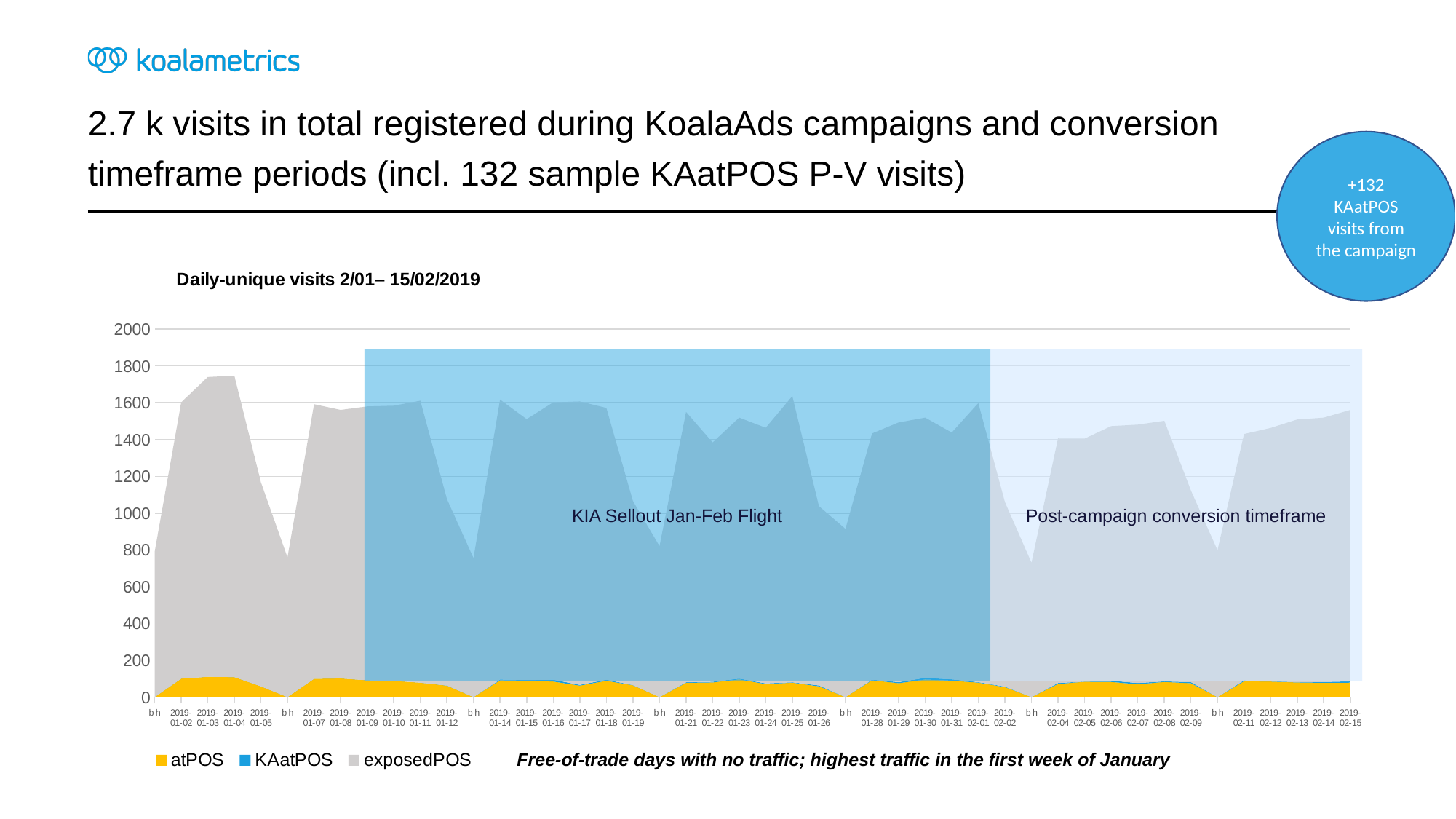
How many x-axis labels on the chart read "b h"? 7 What is the title of the chart? Daily-unique visits 2/01– 15/02/2019 Is the exposedPOS value on 2019-01-05 greater or less than 1000? greater Is the exposedPOS value on 2019-01-14 greater or less than 1400? greater Is the atPOS value on 2019-01-03 greater or less than 200? less Which date has the larger exposedPOS value, 2019-01-03 or 2019-01-05? 2019-01-03 How many series does the chart legend list? 3 What kind of chart is shown on the slide? area chart What is the highest value shown on the chart's vertical axis? 2000 What are the three series named in the chart legend? atPOS, KAatPOS, exposedPOS On 2019-01-03, which series has the larger value, exposedPOS or atPOS? exposedPOS